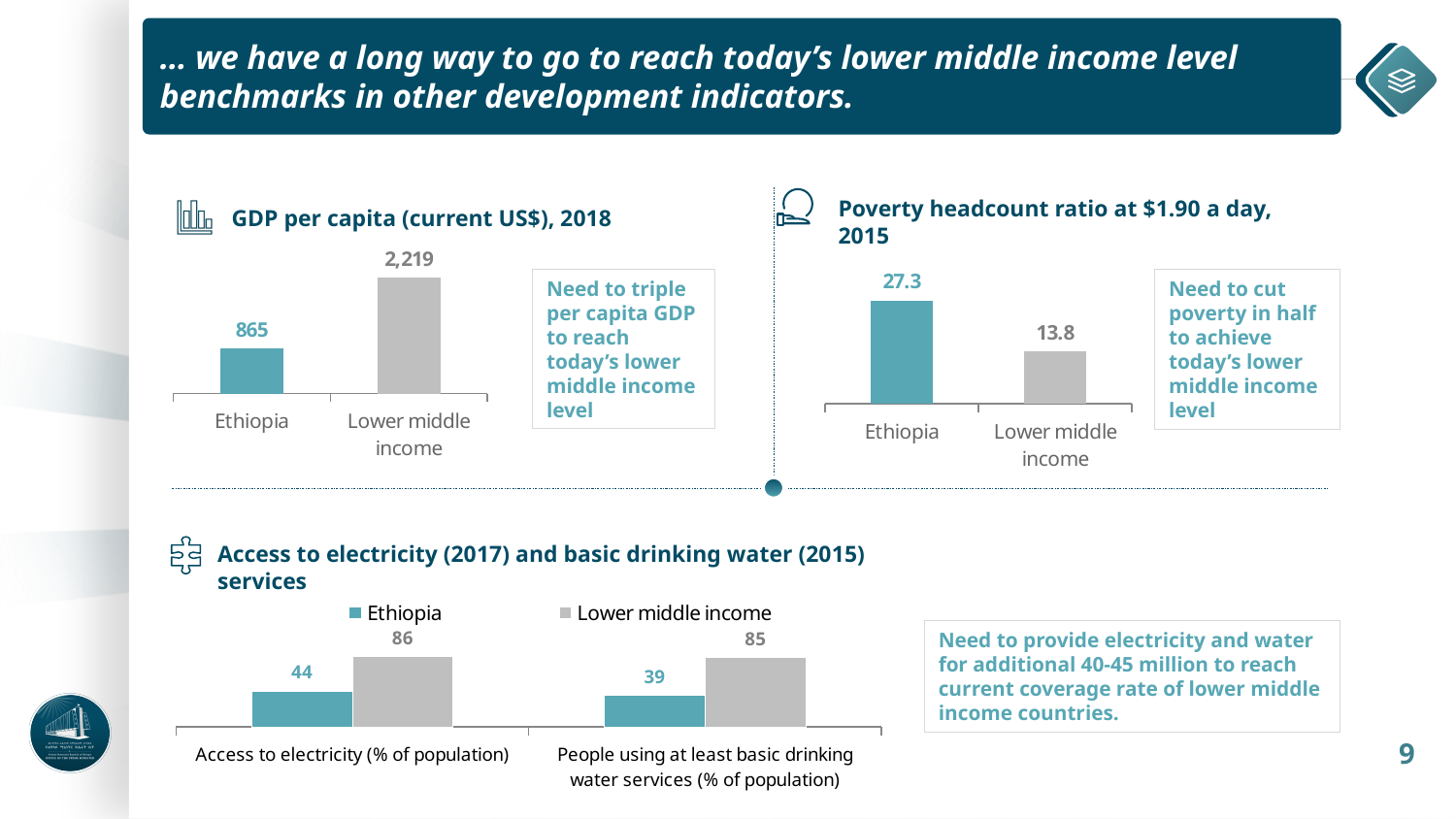
In the 'GDP per capita (current US$), 2018' chart, what is the value for Lower middle income? 2,219 In the 'GDP per capita (current US$), 2018' chart, which category has the higher value? Lower middle income In the 'Poverty headcount ratio at $1.90 a day, 2015' chart, what is the value for Ethiopia? 27.3 In the 'Access to electricity (2017) and basic drinking water (2015) services' chart, what is the value for Lower middle income for People using at least basic drinking water services (% of population)? 85 In the 'Poverty headcount ratio at $1.90 a day, 2015' chart, which category has the lower value? Lower middle income In the 'Access to electricity (2017) and basic drinking water (2015) services' chart, what is the difference between Lower middle income and Ethiopia for Access to electricity (% of population)? 42 In the 'Access to electricity (2017) and basic drinking water (2015) services' chart, how many series does the legend list? 2 In the 'Poverty headcount ratio at $1.90 a day, 2015' chart, what is the difference between Ethiopia and Lower middle income? 13.5 In the 'Access to electricity (2017) and basic drinking water (2015) services' chart, what is the value for Ethiopia for Access to electricity (% of population)? 44 What kind of chart is the 'GDP per capita (current US$), 2018' chart? Bar chart In the 'GDP per capita (current US$), 2018' chart, what is the value for Ethiopia? 865 In the 'Access to electricity (2017) and basic drinking water (2015) services' chart, which colour represents Ethiopia? Teal